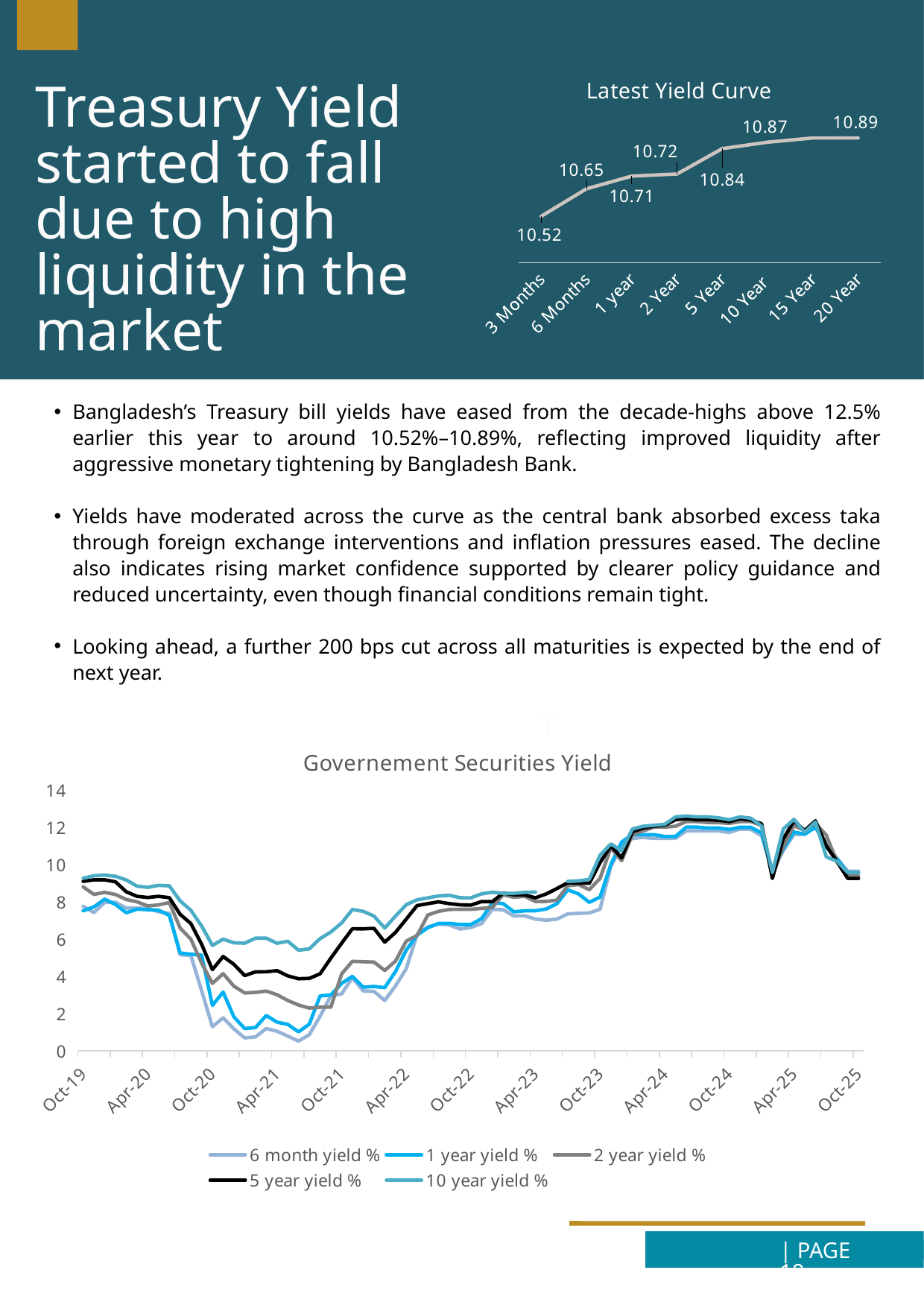
In the Latest Yield Curve chart, what is the yield for 1 year? 10.71 In the Latest Yield Curve chart, which is larger, the 6 Months yield or the 2 Year yield? 2 Year In the Latest Yield Curve chart, what is the yield for 3 Months? 10.52 In the Governement Securities Yield chart, do the yields rise or fall between Apr-25 and Oct-25? Fall In the Latest Yield Curve chart, what is the difference between the 10 Year yield and the 3 Months yield? 0.35 In the Governement Securities Yield chart, is the 5 year yield % at Apr-24 greater or less than 10? greater In the Latest Yield Curve chart, which maturity has the lowest yield? 3 Months In the Latest Yield Curve chart, what is the yield for 5 Year? 10.84 What kind of chart is the Governement Securities Yield chart? Line chart In the Governement Securities Yield chart, how many series does the legend list? 5 In the Latest Yield Curve chart, how many maturities are shown on the x axis? 8